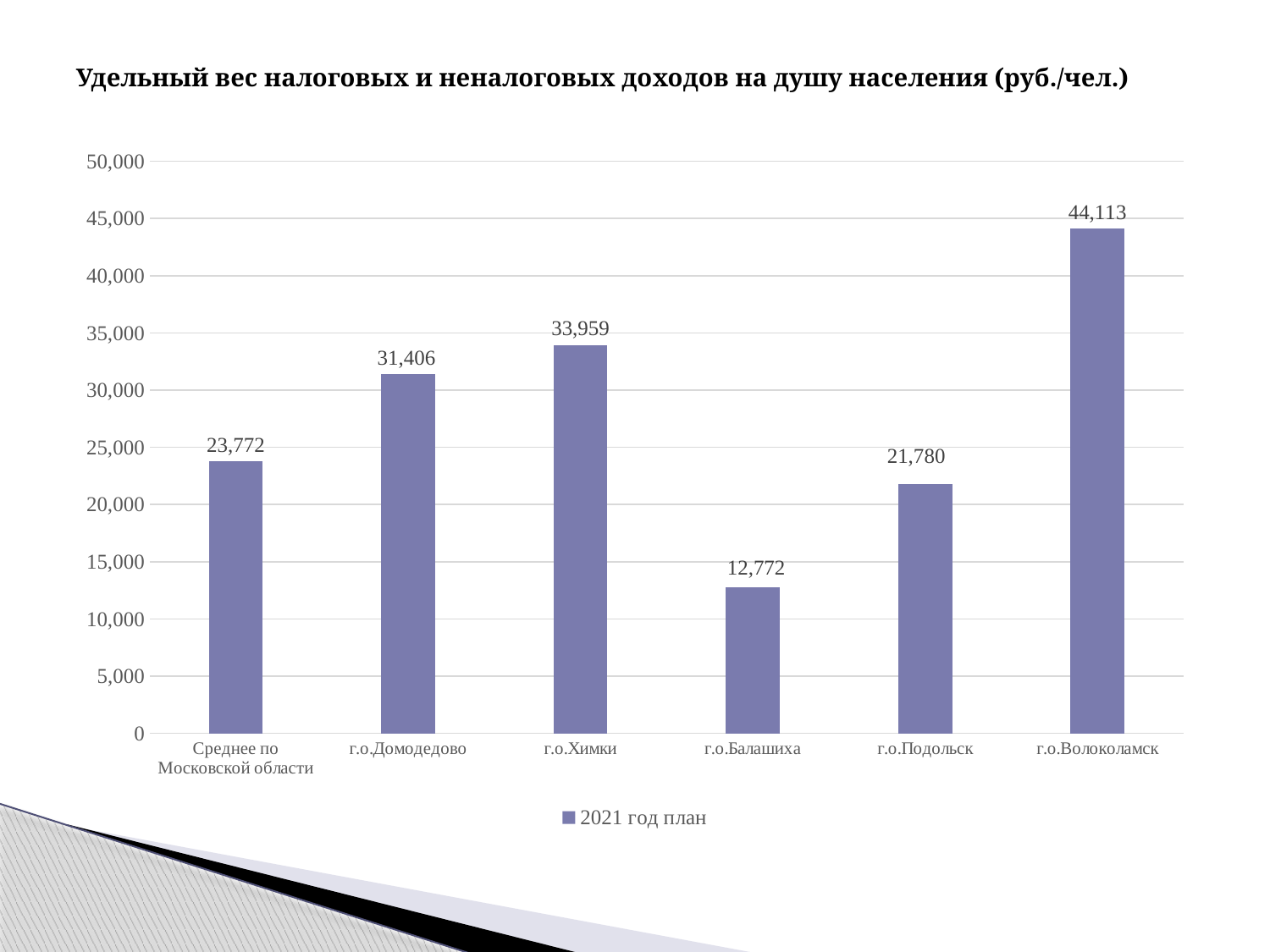
What kind of chart is shown on the slide? bar chart How many series does the legend list? 1 Which category has the highest value? г.о.Волоколамск Is the value for г.о.Подольск greater or less than 25,000? less What is the value for г.о.Домодедово? 31,406 What is the difference between the values for г.о.Домодедово and г.о.Подольск? 9,626 What is the value for Среднее по Московской области? 23,772 How many categories are shown on the x axis? 6 What is the difference between the values for г.о.Волоколамск and г.о.Химки? 10,154 Which is larger, the value for г.о.Химки or the value for г.о.Домодедово? г.о.Химки What is the value for г.о.Балашиха? 12,772 Which category has the lowest value? г.о.Балашиха